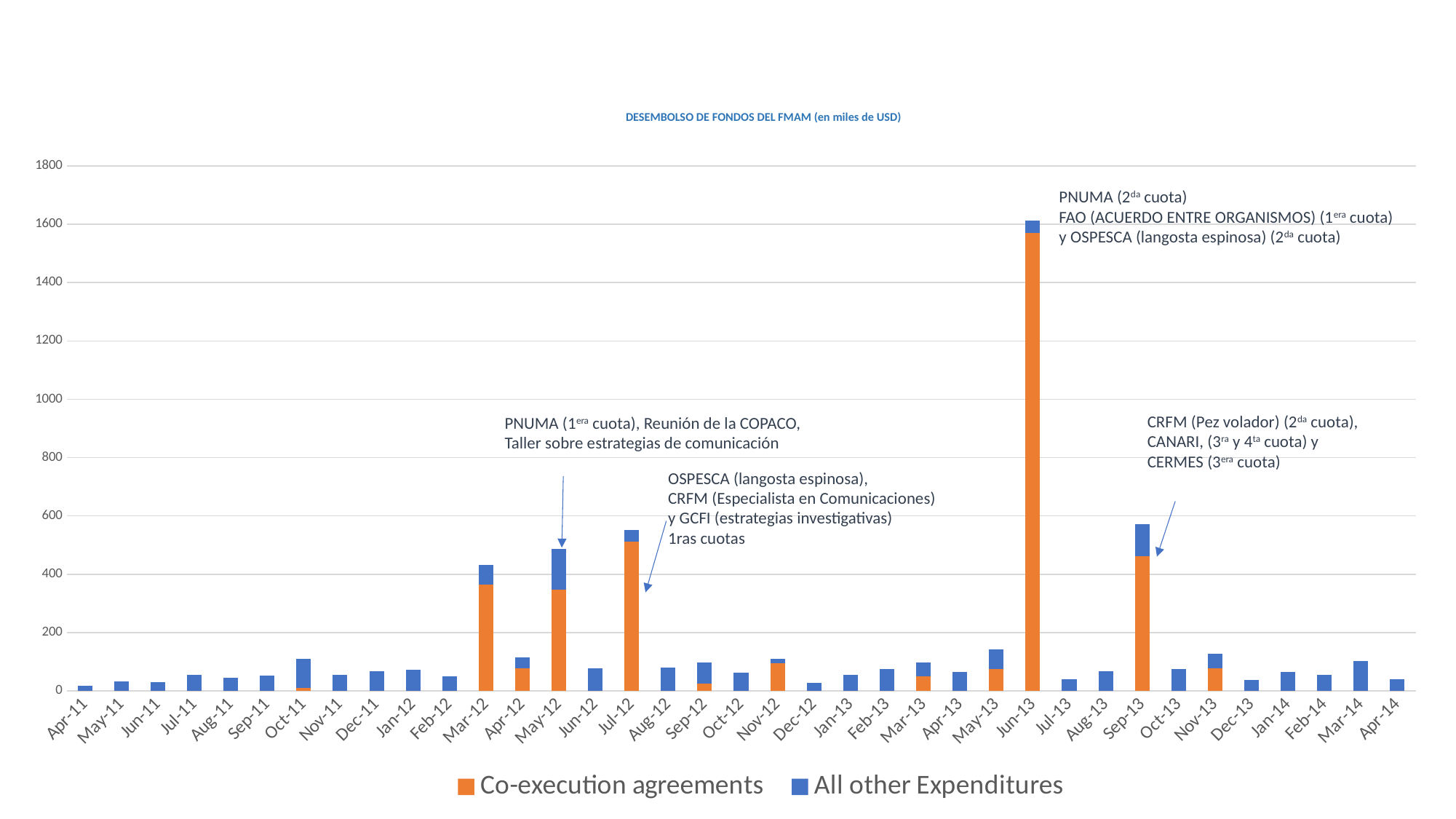
Is the total value for Apr-11 greater or less than 200? less Is the total value for Mar-12 greater or less than 400? greater Is the total value for Jun-13 greater or less than 1400? greater Which has the larger total bar, Jun-13 or Sep-13? Jun-13 Which month has the highest total bar? Jun-13 Which has the larger total bar, Mar-12 or Apr-12? Mar-12 How many series does the legend list? 2 What is the title of the chart? DESEMBOLSO DE FONDOS DEL FMAM (en miles de USD) What kind of chart is shown on the slide? Bar chart How many months are shown along the x axis? 37 Which series is shown in orange? Co-execution agreements